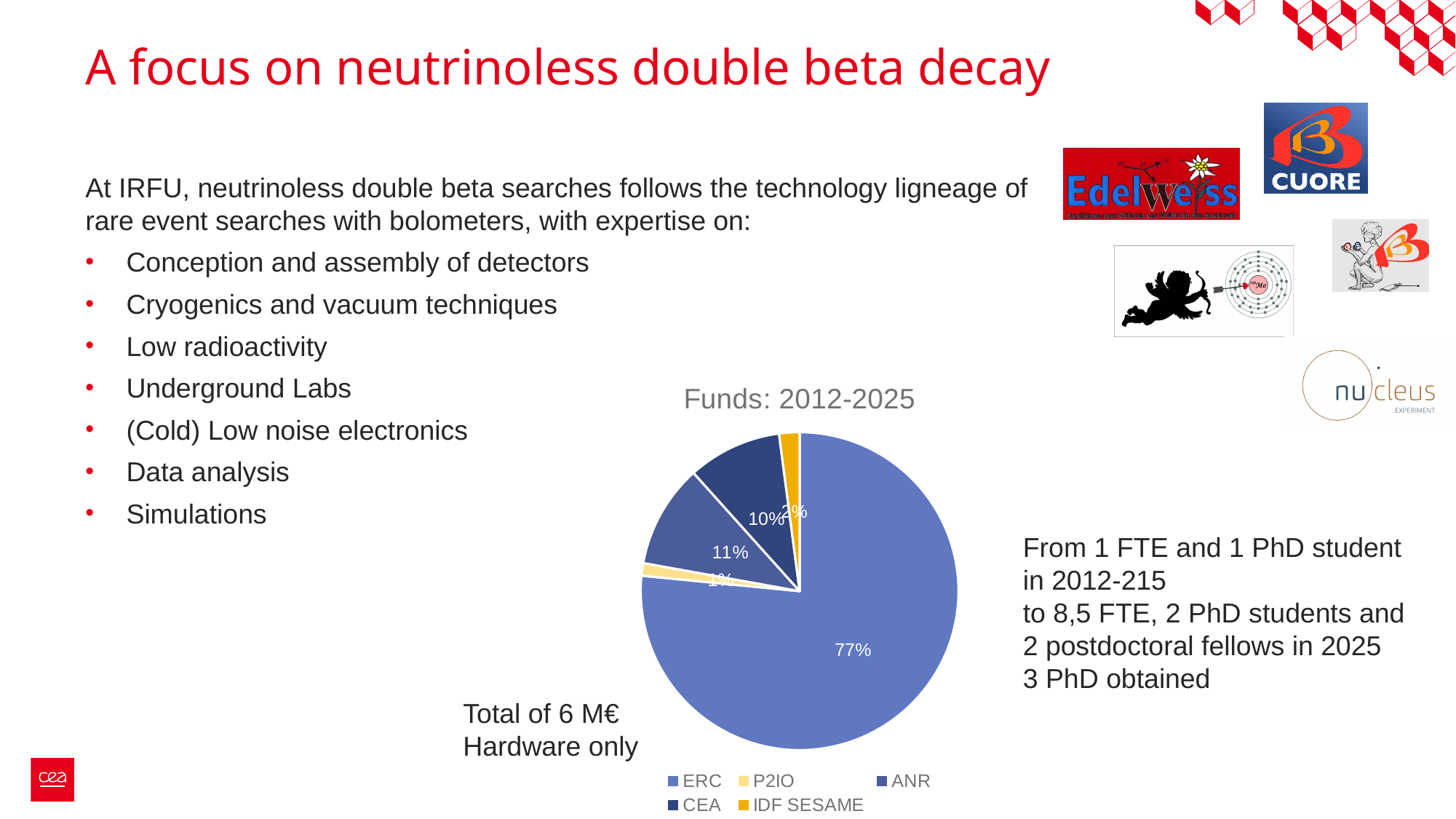
What kind of chart is shown on the slide? pie chart What share of the funds does ANR account for in the pie chart? 11% What share of the funds does CEA account for in the pie chart? 10% Which funding source has the largest slice in the pie chart? ERC What share of the funds does ERC account for in the pie chart? 77% Which has the larger share in the pie chart, ANR or CEA? ANR Which legend entry in the pie chart is shown in gold/orange colour? IDF SESAME What is the title of the pie chart? Funds: 2012-2025 How many funding sources does the legend of the pie chart list? 5 By how many percentage points does the ERC share exceed the ANR share in the pie chart? 66 Which funding source has the smallest slice in the pie chart? P2IO